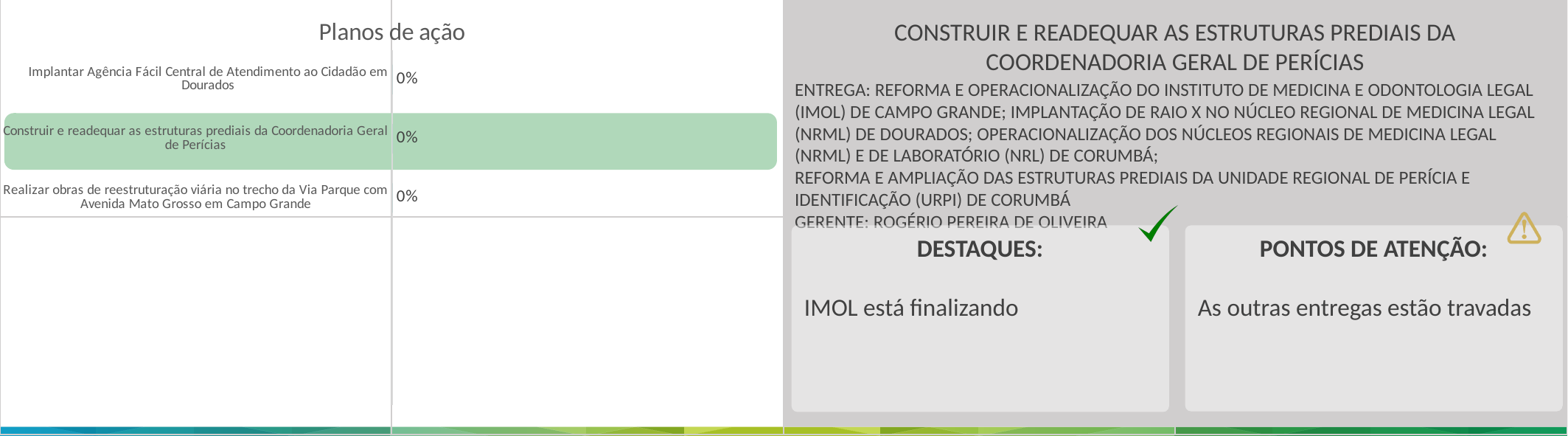
In the 'Planos de ação' chart, what value is shown for 'Implantar Agência Fácil Central de Atendimento ao Cidadão em Dourados'? 0% In the 'Planos de ação' chart, which category row is highlighted with a green background? Construir e readequar as estruturas prediais da Coordenadoria Geral de Perícias What is the title of the chart on the left side of the slide? Planos de ação In the 'Planos de ação' chart, what value is shown for 'Construir e readequar as estruturas prediais da Coordenadoria Geral de Perícias'? 0% In the 'Planos de ação' chart, what is the difference between the value for 'Implantar Agência Fácil Central de Atendimento ao Cidadão em Dourados' and the value for 'Realizar obras de reestruturação viária no trecho da Via Parque com Avenida Mato Grosso em Campo Grande'? 0% How many categories are listed in the 'Planos de ação' chart? 3 In the 'Planos de ação' chart, is the value for 'Construir e readequar as estruturas prediais da Coordenadoria Geral de Perícias' greater than 0%? No In the 'Planos de ação' chart, what value is shown for 'Realizar obras de reestruturação viária no trecho da Via Parque com Avenida Mato Grosso em Campo Grande'? 0% What kind of chart is the 'Planos de ação' chart? bar chart